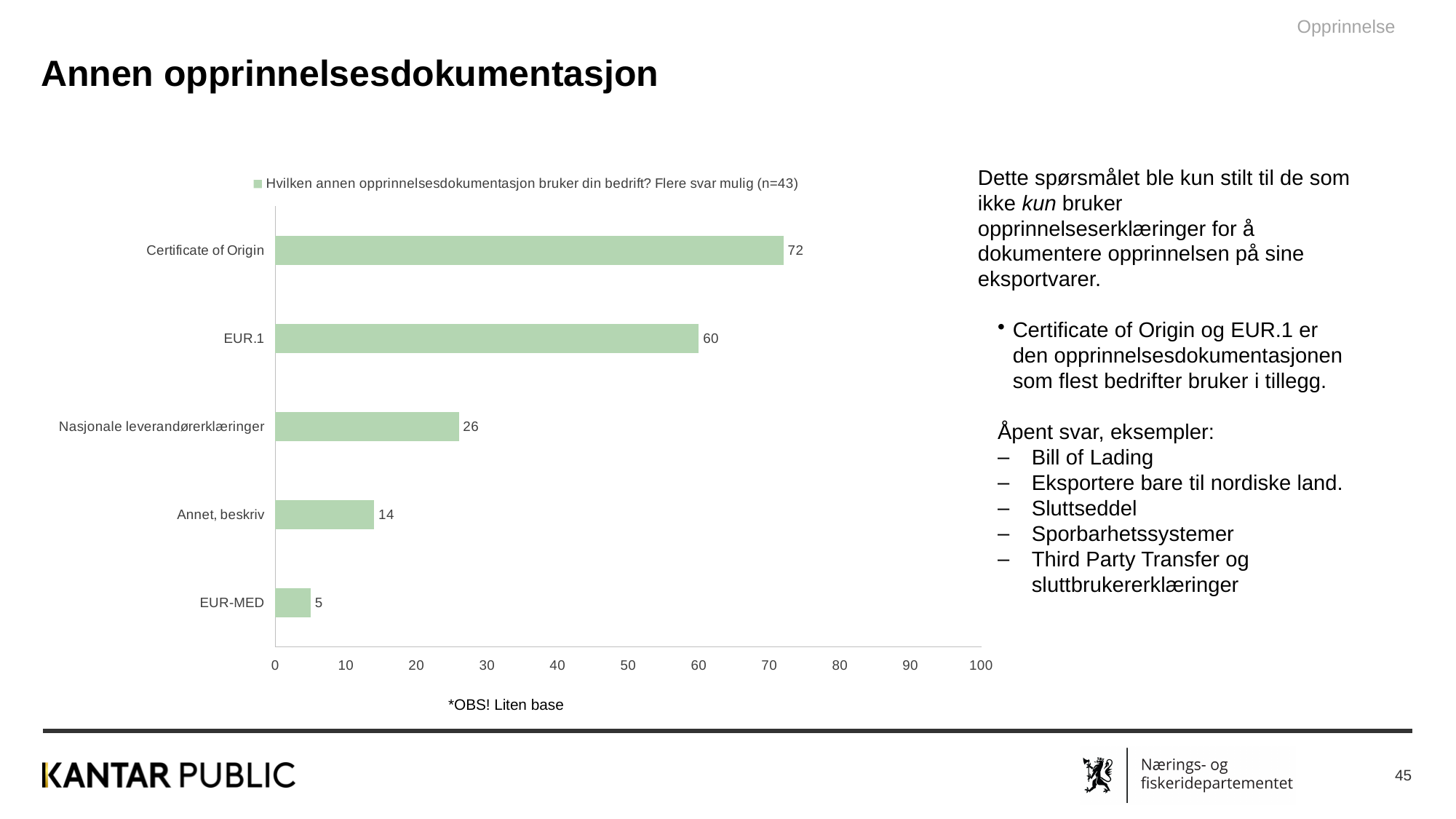
How many categories are shown in the chart? 5 What is the value for EUR-MED? 5 What is the difference between the values for Certificate of Origin and EUR.1? 12 What is the sample size (n) stated in the chart legend? n=43 Which category has the lowest value? EUR-MED Is the value for EUR.1 greater or less than 50? greater What kind of chart is shown on the slide? Bar chart Which is larger, the value for Nasjonale leverandørerklæringer or the value for Annet, beskriv? Nasjonale leverandørerklæringer What is the value for Nasjonale leverandørerklæringer? 26 What is the value for Certificate of Origin? 72 Which category has the highest value? Certificate of Origin What is the value for EUR.1? 60